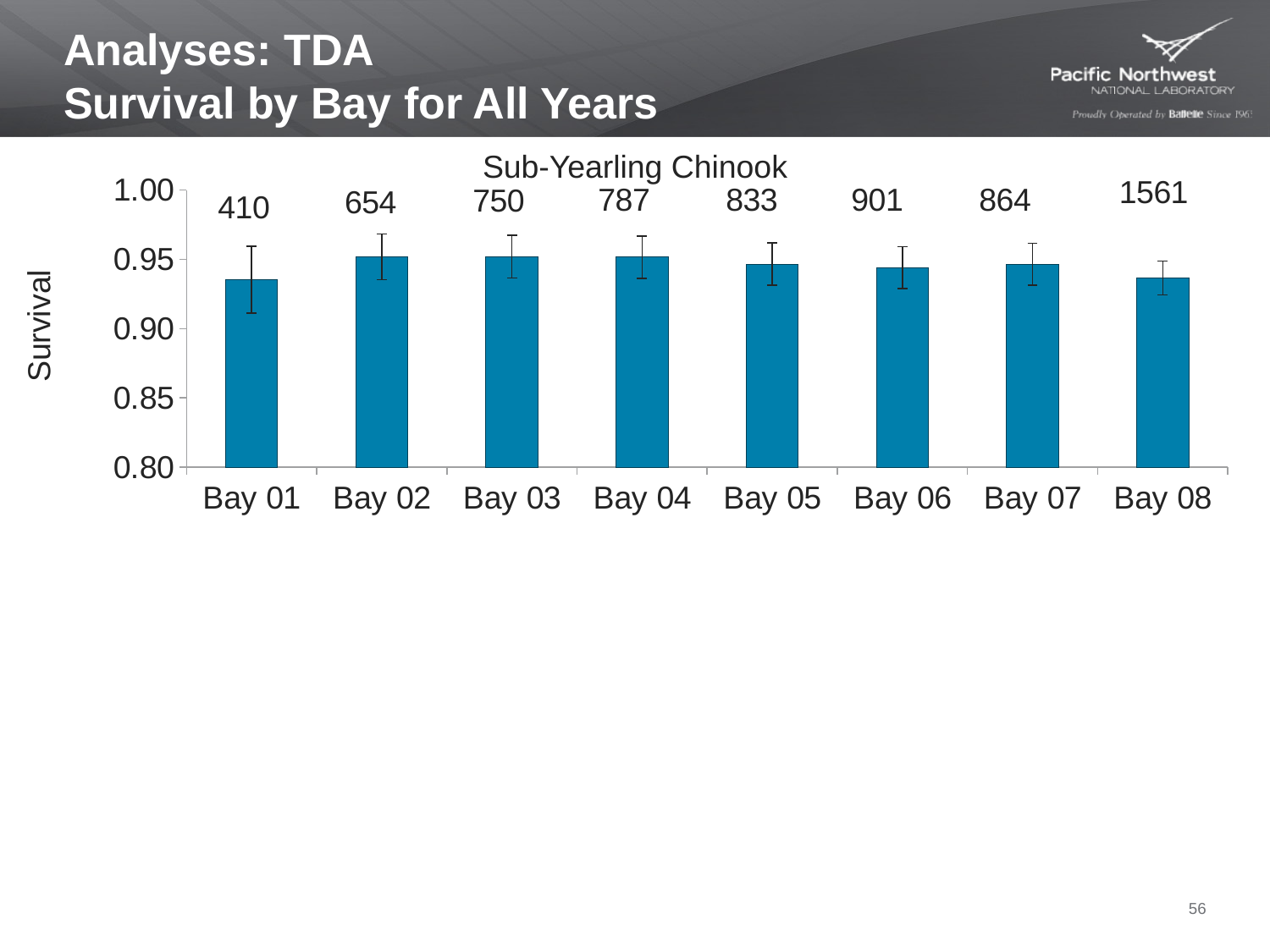
Is the survival value for Bay 01 greater or less than 0.90? greater What is the title of the chart? Sub-Yearling Chinook What is the label on the y axis of the chart? Survival How many bays are shown on the x axis of the chart? 8 Are all of the survival bars in the chart above 0.90? yes Is the survival value for Bay 08 greater or less than 0.95? less Which has the higher survival value, Bay 01 or Bay 02? Bay 02 What kind of chart is shown on the slide? bar chart Which has the higher survival value, Bay 03 or Bay 08? Bay 03